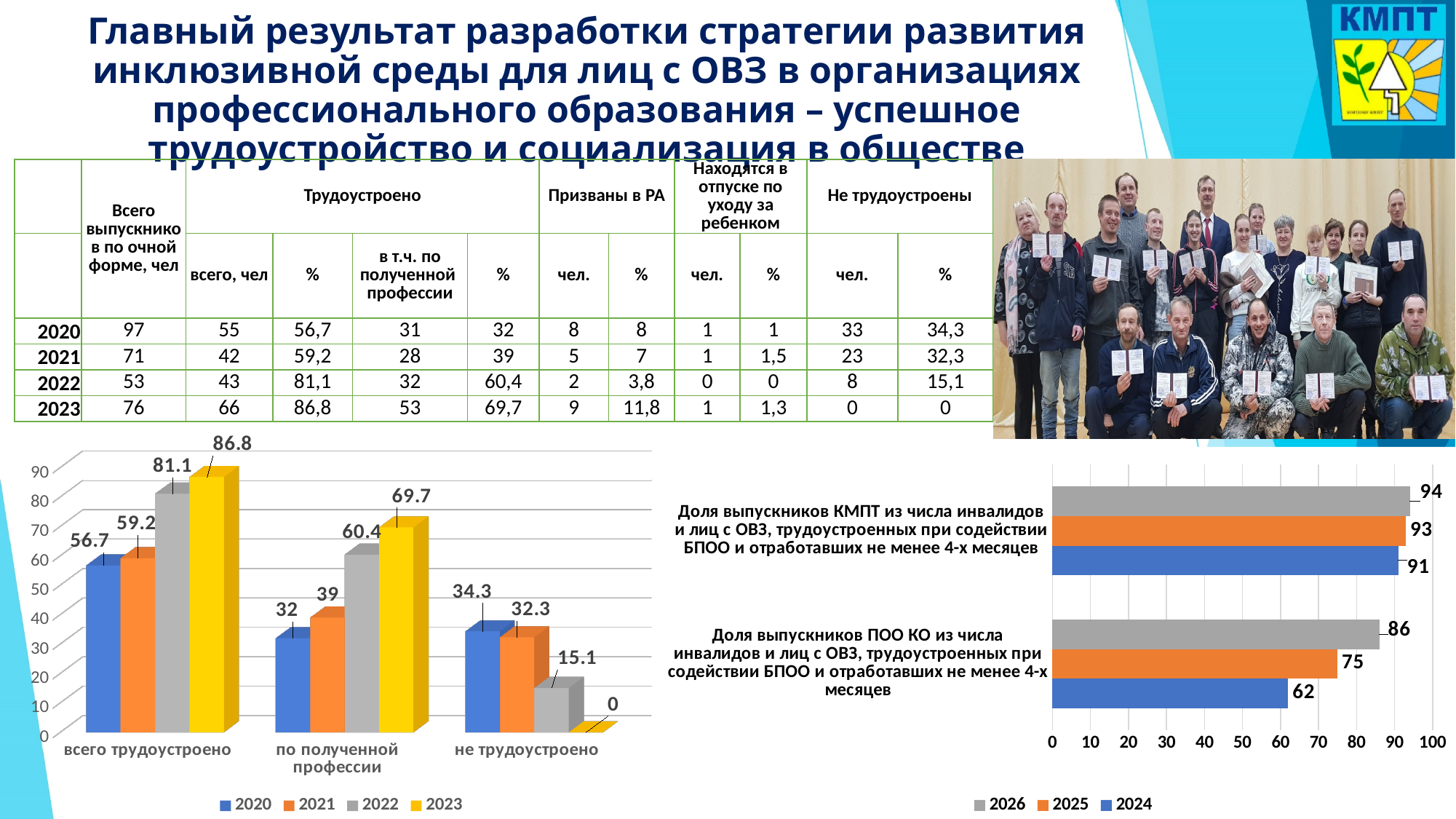
In the right chart, what is the value for 2026 for "Доля выпускников КМПТ из числа инвалидов и лиц с ОВЗ, трудоустроенных при содействии БПОО и отработавших не менее 4-х месяцев"? 94 In the left bar chart, what is the value for 2021 in the category "по полученной профессии"? 39 In the right chart, what is the difference between the 2026 and 2025 values for "Доля выпускников ПОО КО..."? 11 In the right chart, what is the value for 2024 for "Доля выпускников ПОО КО из числа инвалидов и лиц с ОВЗ, трудоустроенных при содействии БПОО и отработавших не менее 4-х месяцев"? 62 In the left bar chart, which is larger: the 2020 value or the 2021 value in the category "не трудоустроено"? 2020 In the left bar chart, which year has the lowest value in the category "не трудоустроено"? 2023 In the left bar chart, what is the difference between the 2022 and 2020 values in the category "всего трудоустроено"? 24.4 What type of chart is the right chart? bar chart In the right chart, how many series does the legend list? 3 In the left bar chart, do the values in the category "по полученной профессии" rise or fall from 2020 to 2023? rise In the left bar chart, how many series does the legend list? 4 In the left bar chart, what is the value for 2023 in the category "всего трудоустроено"? 86.8